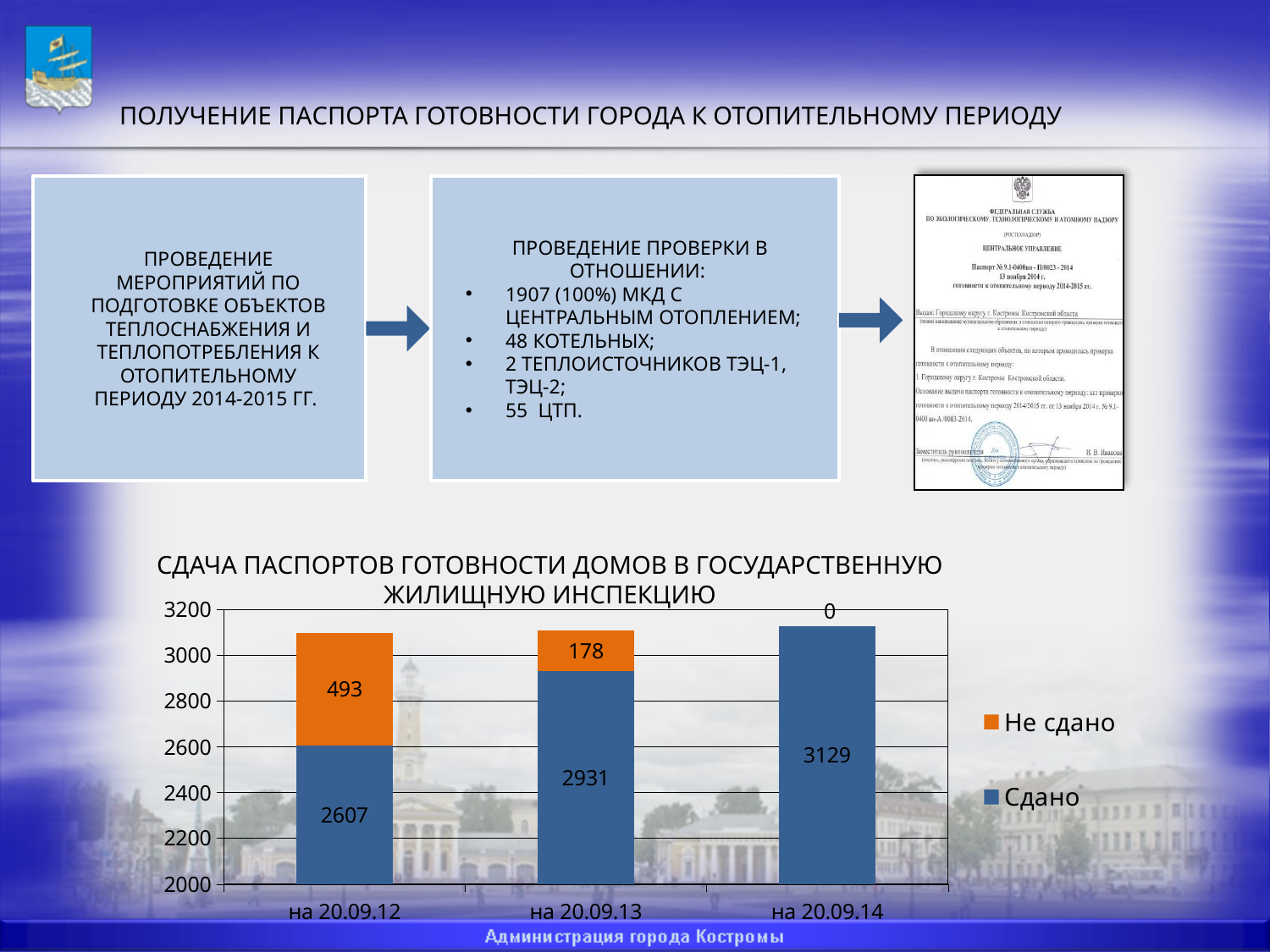
What is the value of "Сдано" for "на 20.09.14"? 3129 Does the "Сдано" value rise or fall from "на 20.09.12" to "на 20.09.14"? rise What is the value of "Не сдано" for "на 20.09.14"? 0 What type of chart is shown on the slide? stacked bar chart What is the value of "Не сдано" for "на 20.09.13"? 178 How many series does the chart legend list? 2 How many categories are shown on the x axis of the chart? 3 What is the difference between the "Сдано" values for "на 20.09.13" and "на 20.09.12"? 324 Which category has the lowest value for "Не сдано"? на 20.09.14 What is the value of "Сдано" for "на 20.09.12"? 2607 What is the total of the stacked bar for "на 20.09.12"? 3100 Which category has the highest value for "Сдано"? на 20.09.14